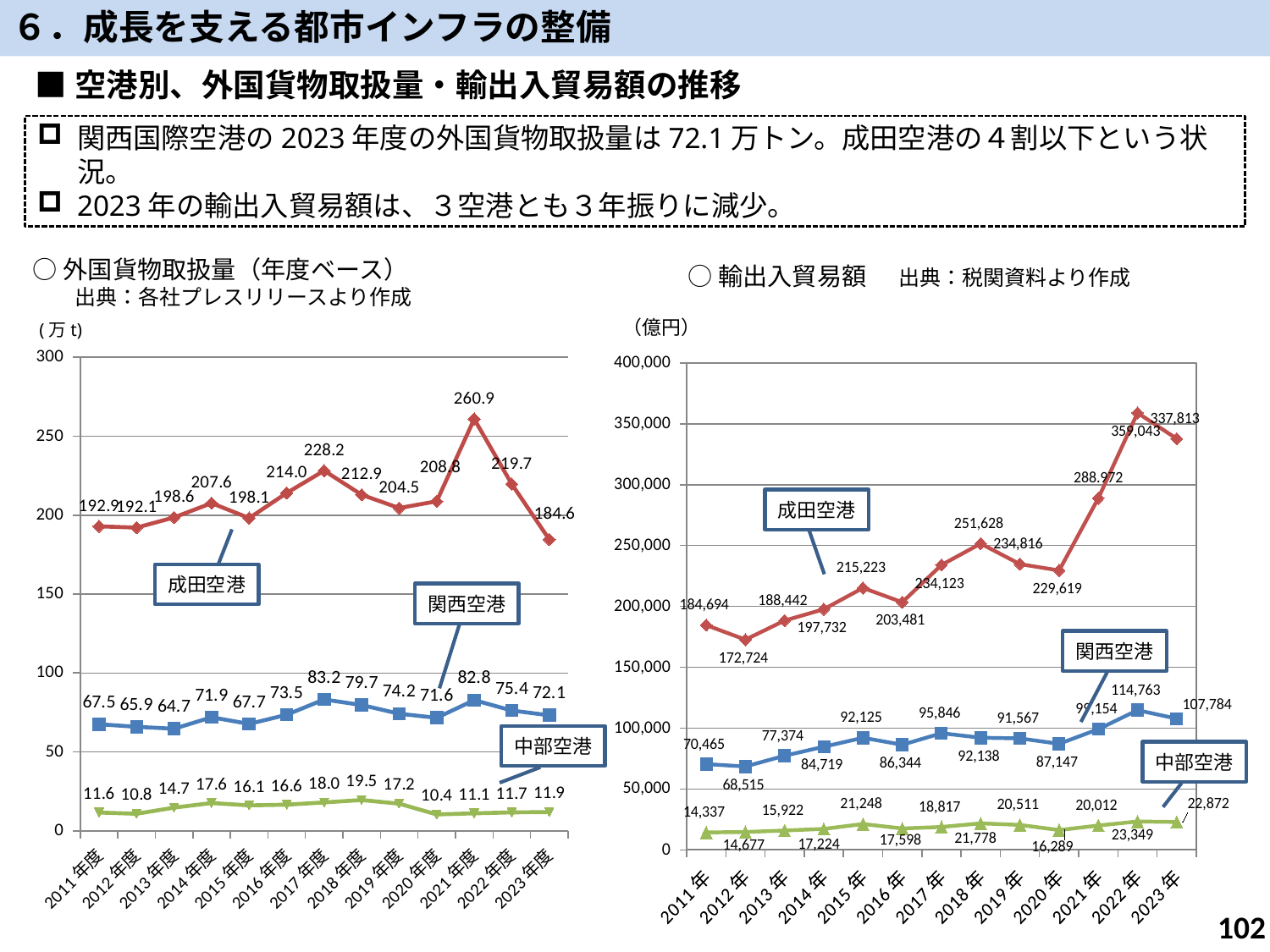
What kind of chart is the right chart (輸出入貿易額)? Line chart In the left chart (外国貨物取扱量), in which year is the value for 中部空港 lowest? 2020年度 In the right chart (輸出入貿易額), is the value for 成田空港 in 2021年 greater or less than 250,000? greater In the left chart (外国貨物取扱量), what is the difference between the 成田空港 values for 2021年度 and 2023年度? 76.3 In the right chart (輸出入貿易額), which is larger: the 関西空港 value in 2022年 or in 2023年? 2022年 In the left chart (外国貨物取扱量), in which year does 成田空港 reach its highest value? 2021年度 In the left chart (外国貨物取扱量), what is the value for 関西空港 in 2017年度? 83.2 In the left chart (外国貨物取扱量), what is the value for 成田空港 in 2023年度? 184.6 In the right chart (輸出入貿易額), what is the value for 中部空港 in 2023年? 22,872 In the left chart (外国貨物取扱量), how many years are shown on the x axis? 13 In the right chart (輸出入貿易額), what is the value for 成田空港 in 2022年? 359,043 In the right chart (輸出入貿易額), what unit is shown on the vertical axis? 億円